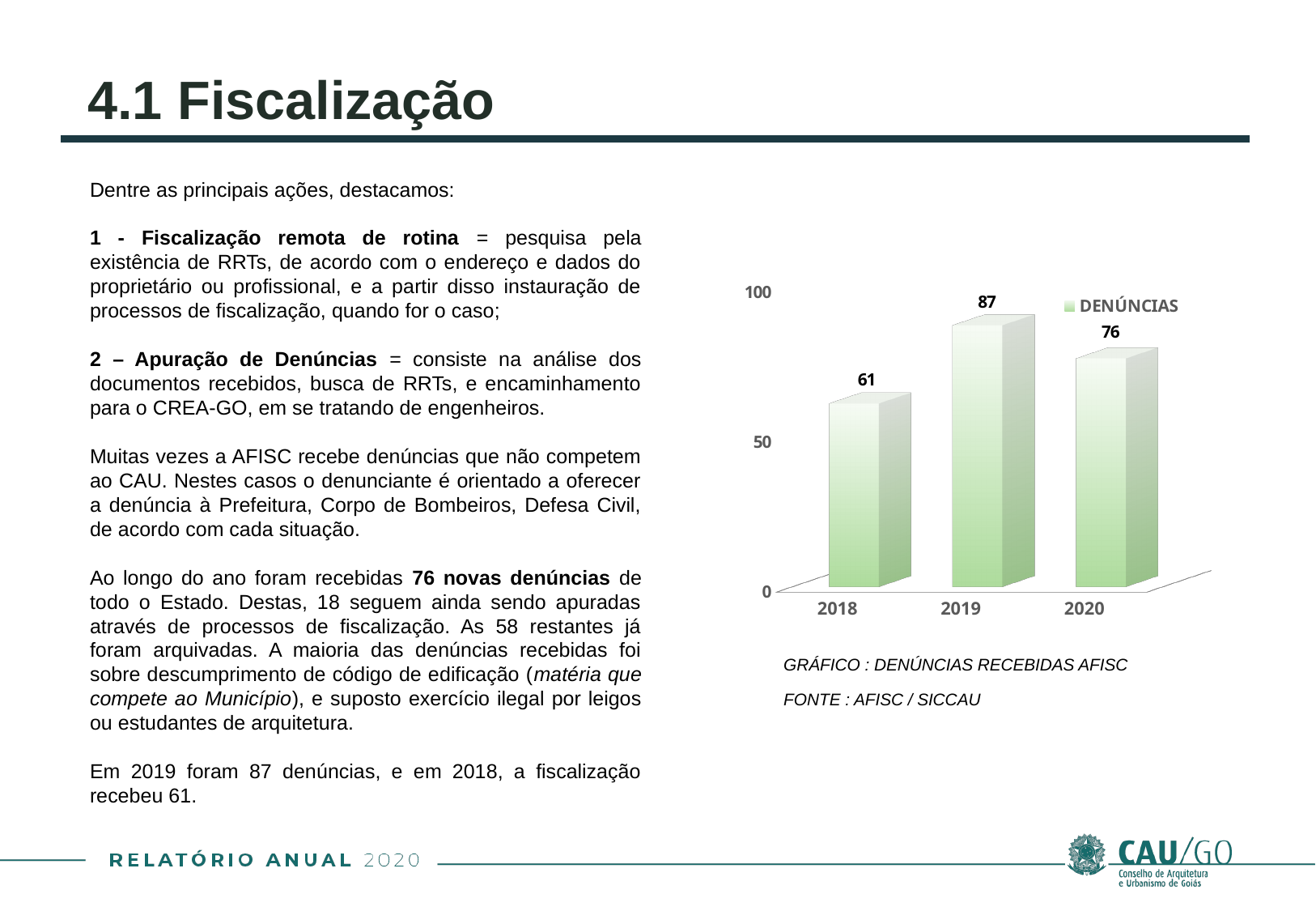
What is the difference between the values for 2019 and 2020? 11 How many years are shown on the x axis of the chart? 3 Which is larger, the value for 2018 or the value for 2020? 2020 What is the value for 2018 in the chart? 61 Which year has the highest value in the chart? 2019 What is the value for 2020 in the chart? 76 Which year has the lowest value in the chart? 2018 What series name is listed in the chart legend? DENÚNCIAS What is the value for 2019 in the chart? 87 What kind of chart is shown on the slide? bar chart Is the value for 2018 greater or less than 50? greater What is the difference between the values for 2020 and 2018? 15